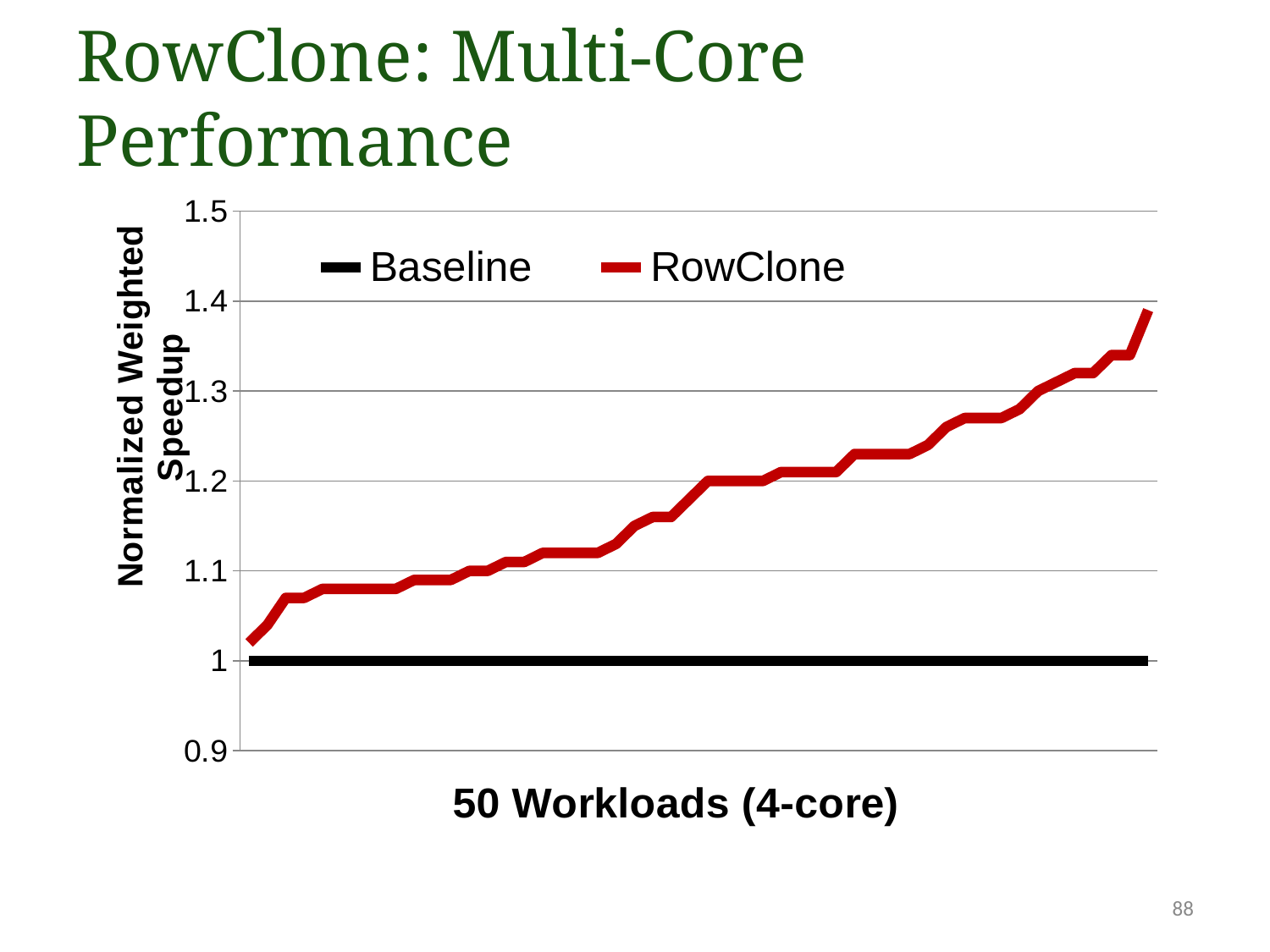
Which series has the higher values, Baseline or RowClone? RowClone Does the RowClone series rise or fall from left to right along the x axis? rise What are the two series named in the legend? Baseline and RowClone Which series is drawn in red? RowClone Is the lowest RowClone value greater or less than 1.1? less How many series does the legend list? 2 What kind of chart is shown on the slide? line chart How many workloads are plotted along the x axis? 50 What is the value of the Baseline series across the workloads? 1 Is the highest RowClone value greater or less than 1.3? greater What is the label of the y axis? Normalized Weighted Speedup